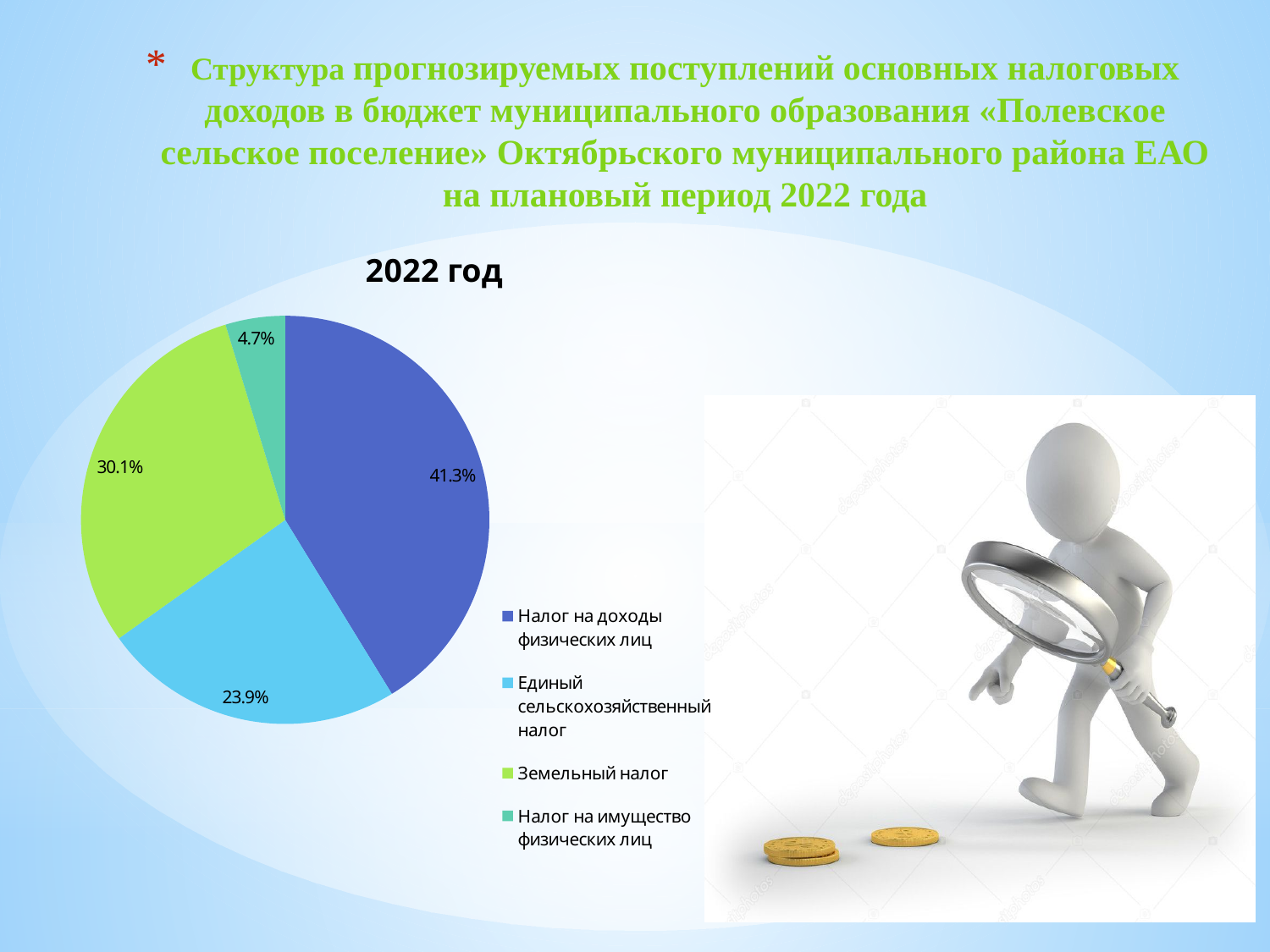
Which category has the smallest slice of the pie? Налог на имущество физических лиц What is the chart's title? 2022 год Which is larger: Земельный налог or Единый сельскохозяйственный налог? Земельный налог What share of the pie does Налог на имущество физических лиц have? 4.7% What is the difference in percentage points between Налог на доходы физических лиц and Земельный налог? 11.2 What share of the pie does Единый сельскохозяйственный налог have? 23.9% How many categories does the pie chart show? 4 Which category has the largest slice of the pie? Налог на доходы физических лиц What share of the pie does Налог на доходы физических лиц have? 41.3% What type of chart is shown on the slide? Pie chart What colour is the slice for Земельный налог? Light green